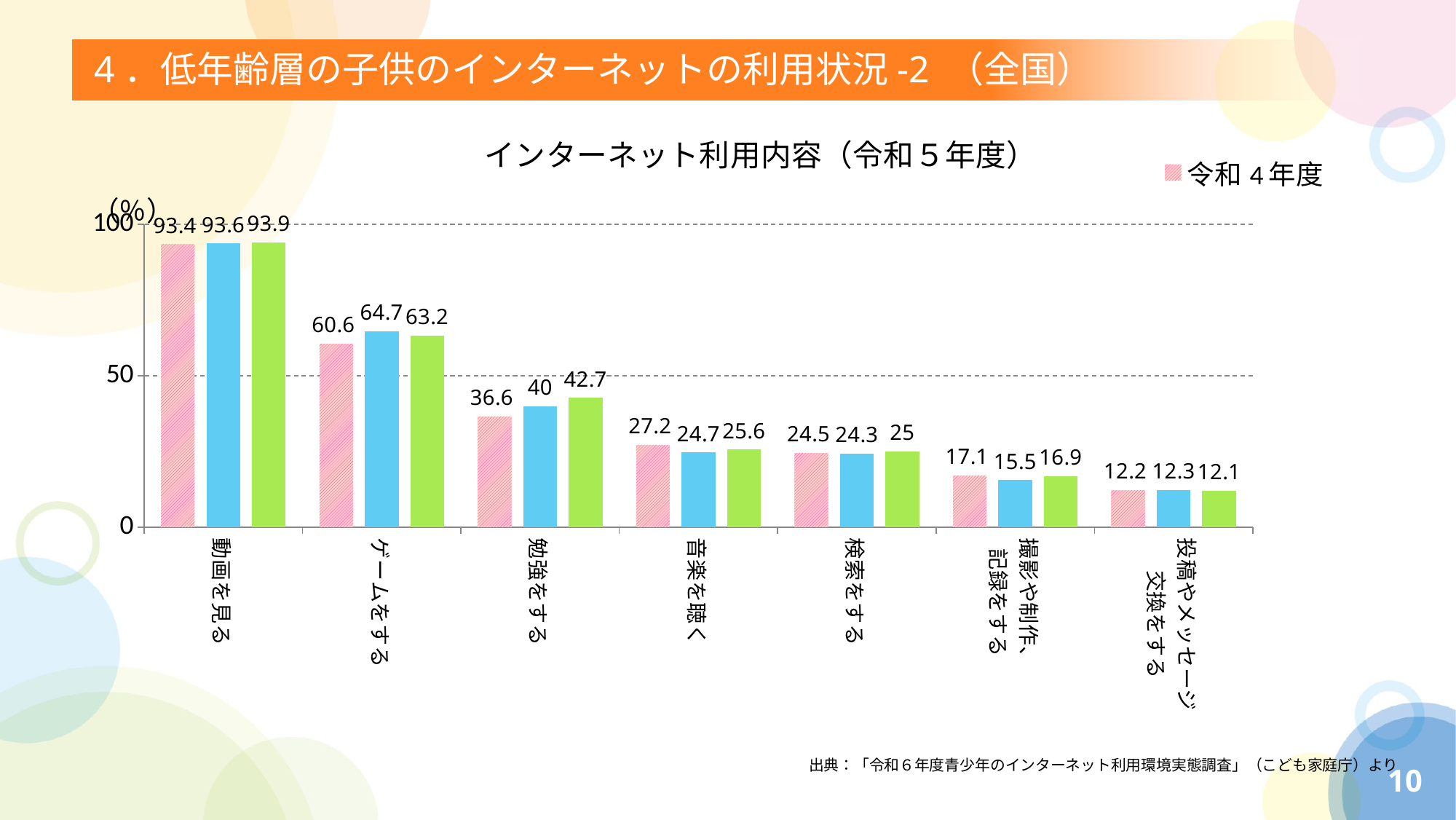
Which category has the highest 令和４年度 value? 動画を見る What value is printed on the green bar for 勉強をする? 42.7 What is the title of the chart? インターネット利用内容（令和５年度） What value is printed on the blue bar for ゲームをする? 64.7 What is the difference between the 令和４年度 values for ゲームをする and 勉強をする? 24 What kind of chart is shown on the slide? bar chart Which category has the lowest 令和４年度 value? 投稿やメッセージ交換をする What is the 令和４年度 value for 動画を見る? 93.4 What is the 令和４年度 value for ゲームをする? 60.6 How many categories are shown along the x axis of the chart? 7 Is the 令和４年度 value for 勉強をする greater or less than 50? less Which has the larger 令和４年度 value, 音楽を聴く or 検索をする? 音楽を聴く